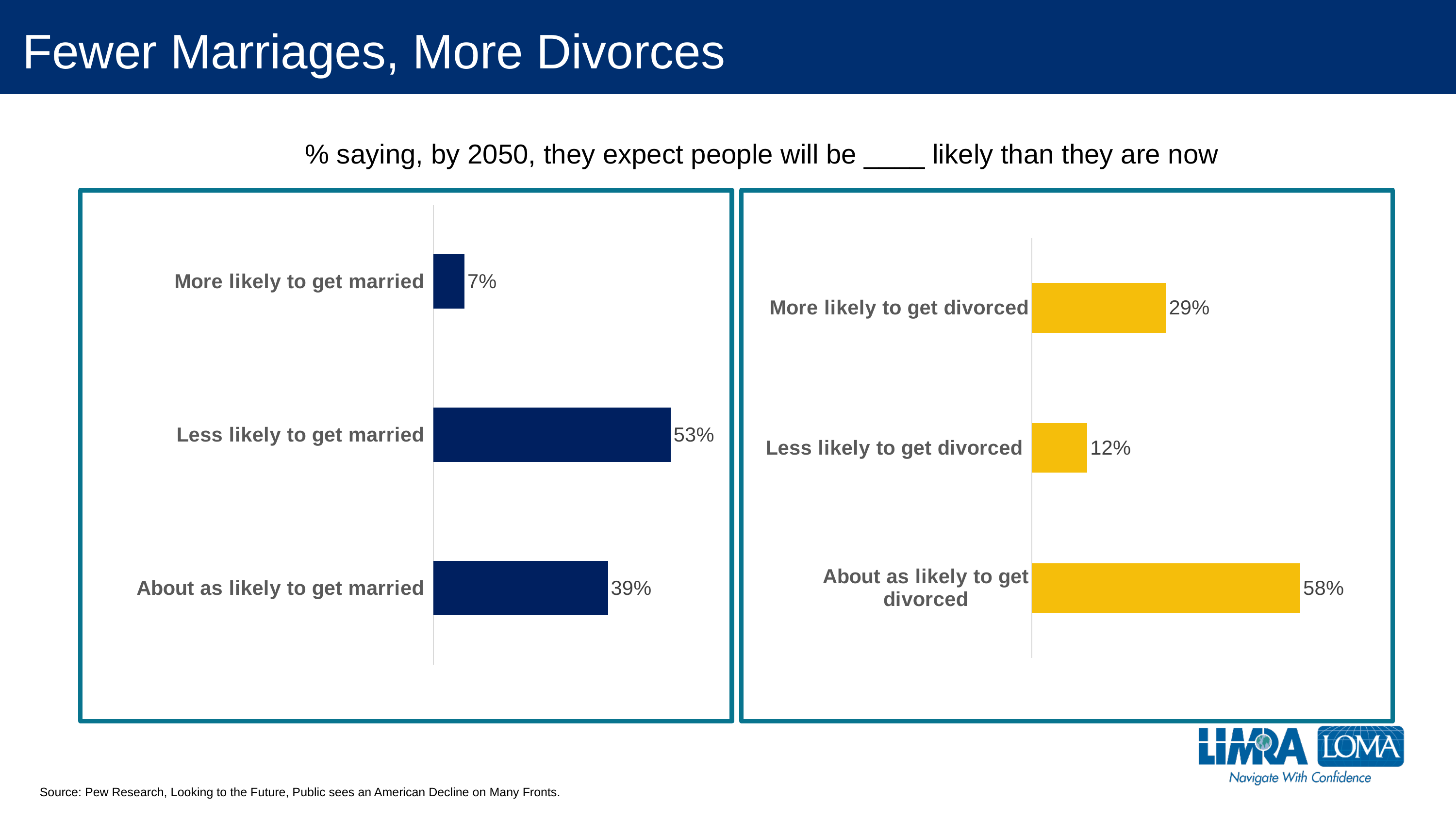
How many categories are shown in the left chart (marriage)? 3 In the left chart (marriage), what percentage say people will be more likely to get married? 7% In the right chart (divorce), which is larger: 'More likely to get divorced' or 'Less likely to get divorced'? More likely to get divorced What colour are the bars in the right chart (divorce)? Yellow In the right chart (divorce), what percentage say people will be more likely to get divorced? 29% In the right chart (divorce), what is the difference between 'More likely to get divorced' and 'Less likely to get divorced'? 17% In the right chart (divorce), which category has the lowest value? Less likely to get divorced In the left chart (marriage), what is the difference between the 'Less likely to get married' and 'About as likely to get married' values? 14% In the left chart (marriage), which category has the highest value? Less likely to get married In the right chart (divorce), what percentage say people will be about as likely to get divorced? 58% What type of chart is the right chart (divorce)? Bar chart In the left chart (marriage), what percentage say people will be less likely to get married by 2050? 53%